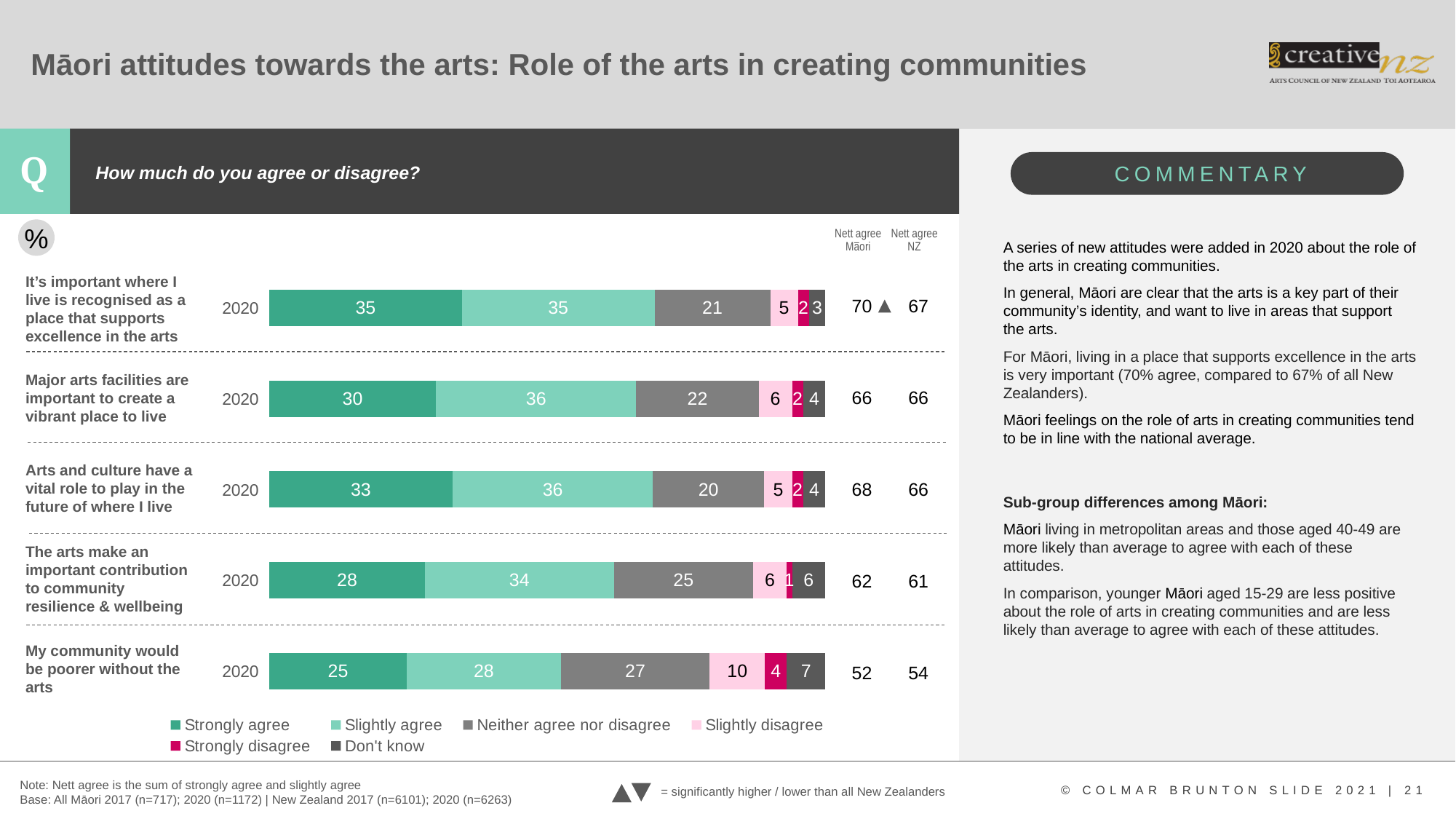
How many statements (bars) are plotted in the chart? 5 What is the Nett agree Māori figure for 'Arts and culture have a vital role to play in the future of where I live'? 68 What percentage of Māori strongly agree that 'My community would be poorer without the arts'? 25 What is the difference in 'Strongly agree' between 'It's important where I live is recognised as a place that supports excellence in the arts' and 'My community would be poorer without the arts'? 10 Which statement has the highest 'Strongly agree' value? It's important where I live is recognised as a place that supports excellence in the arts What is the 'Neither agree nor disagree' value for 'The arts make an important contribution to community resilience & wellbeing'? 25 Which has the larger 'Slightly agree' value: 'Major arts facilities are important to create a vibrant place to live' or 'The arts make an important contribution to community resilience & wellbeing'? Major arts facilities are important to create a vibrant place to live Which statement has the lowest 'Slightly agree' value? My community would be poorer without the arts Which statement has the highest 'Don't know' value? My community would be poorer without the arts What kind of chart is shown on the slide? Stacked bar chart How many series does the chart legend list? 6 What is the Nett agree NZ figure for 'My community would be poorer without the arts'? 54